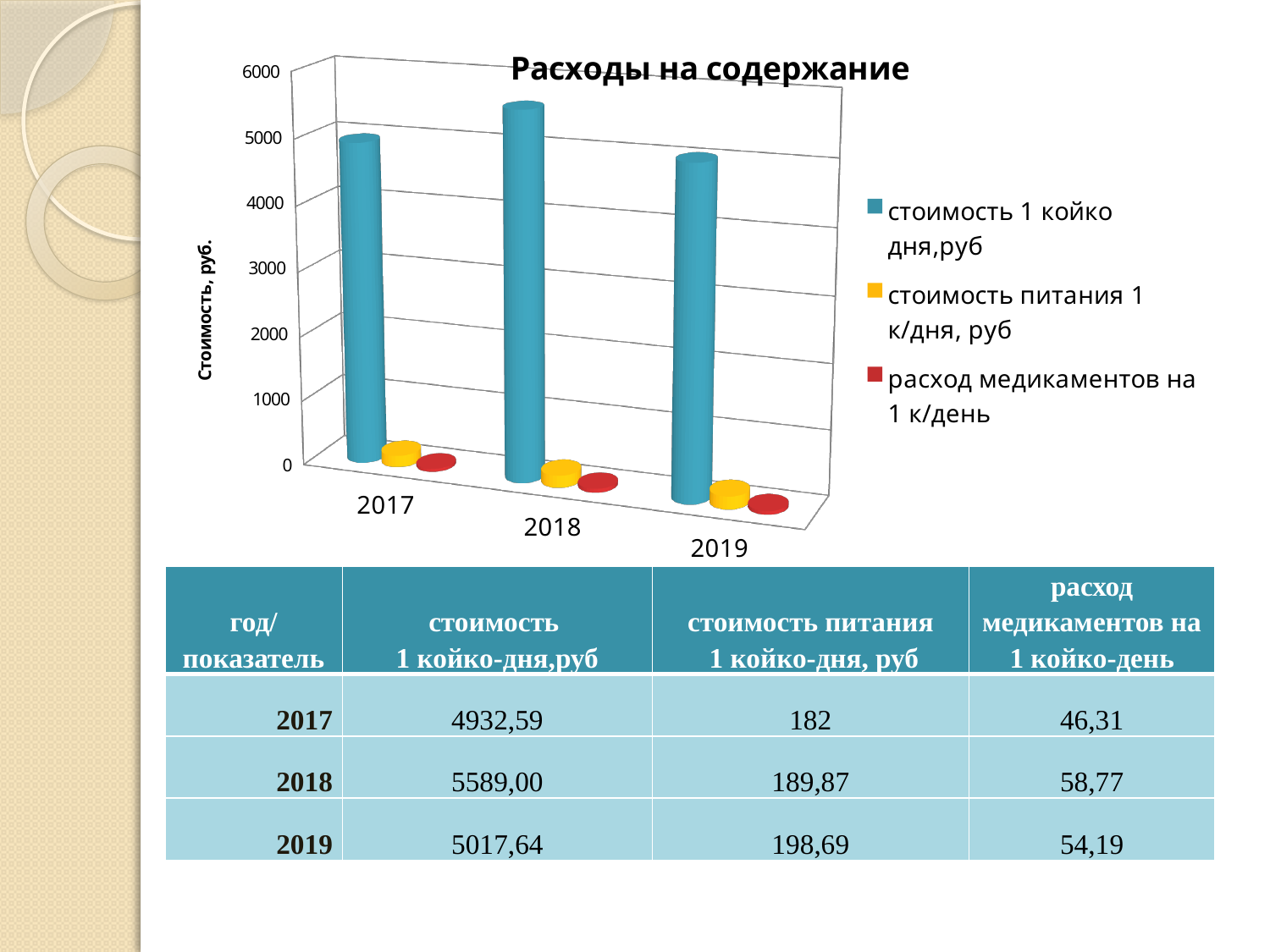
What is the value for стоимость 1 койко-дня, руб in 2019 according to the table on the slide? 5017,64 What kind of chart is shown on the slide? bar chart How many series does the chart legend list? 3 What is the value for стоимость питания 1 койко-дня, руб in 2017 according to the table on the slide? 182 Which year has the lowest value for стоимость 1 койко дня, руб? 2017 Is the value for стоимость питания 1 к/дня, руб in 2019 greater or less than 1000? less Which year has the highest value for стоимость 1 койко дня, руб? 2018 How many years are shown on the x axis of the chart? 3 What is the title of the chart? Расходы на содержание Is the value for стоимость 1 койко дня, руб in 2017 greater or less than 5000? less Which is larger: стоимость 1 койко дня, руб in 2019 or in 2017? 2019 Is the value for стоимость 1 койко дня, руб in 2018 greater or less than 5000? greater